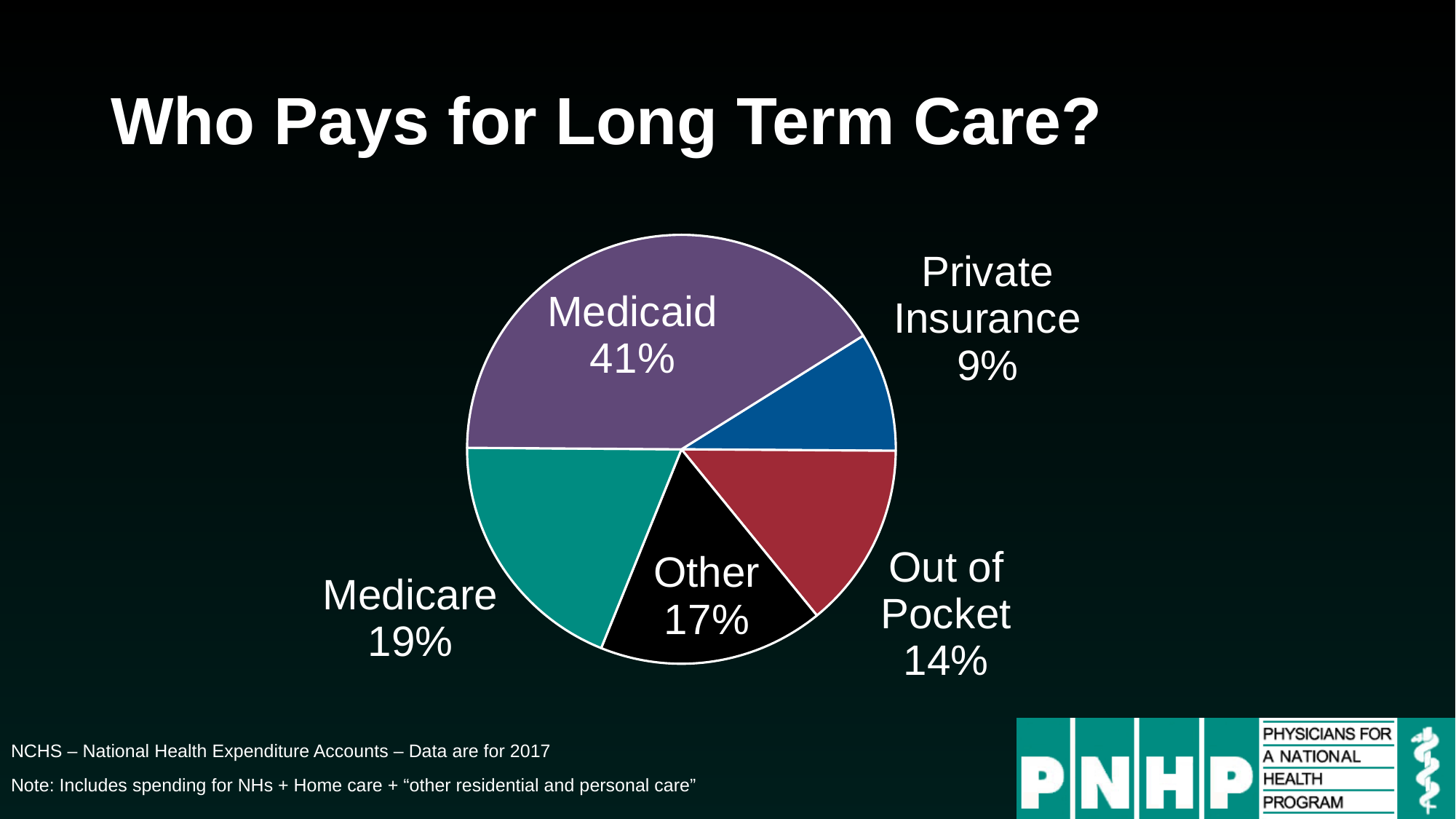
Which payer has the largest share of long term care spending? Medicaid What is the title of the slide? Who Pays for Long Term Care? How many percentage points larger is Medicaid's share than Medicare's share? 22 What colour is the Medicaid slice of the pie chart? Purple How many slices does the pie chart have? 5 What share of long term care spending is paid by Medicare? 19% What share of long term care spending is paid by private insurance? 9% Which payer has the smallest share of long term care spending? Private Insurance What share of long term care spending is paid by Medicaid? 41% What kind of chart is shown on the slide? Pie chart What share of long term care spending is paid out of pocket? 14% Which is larger, the Other share or the Out of Pocket share? Other